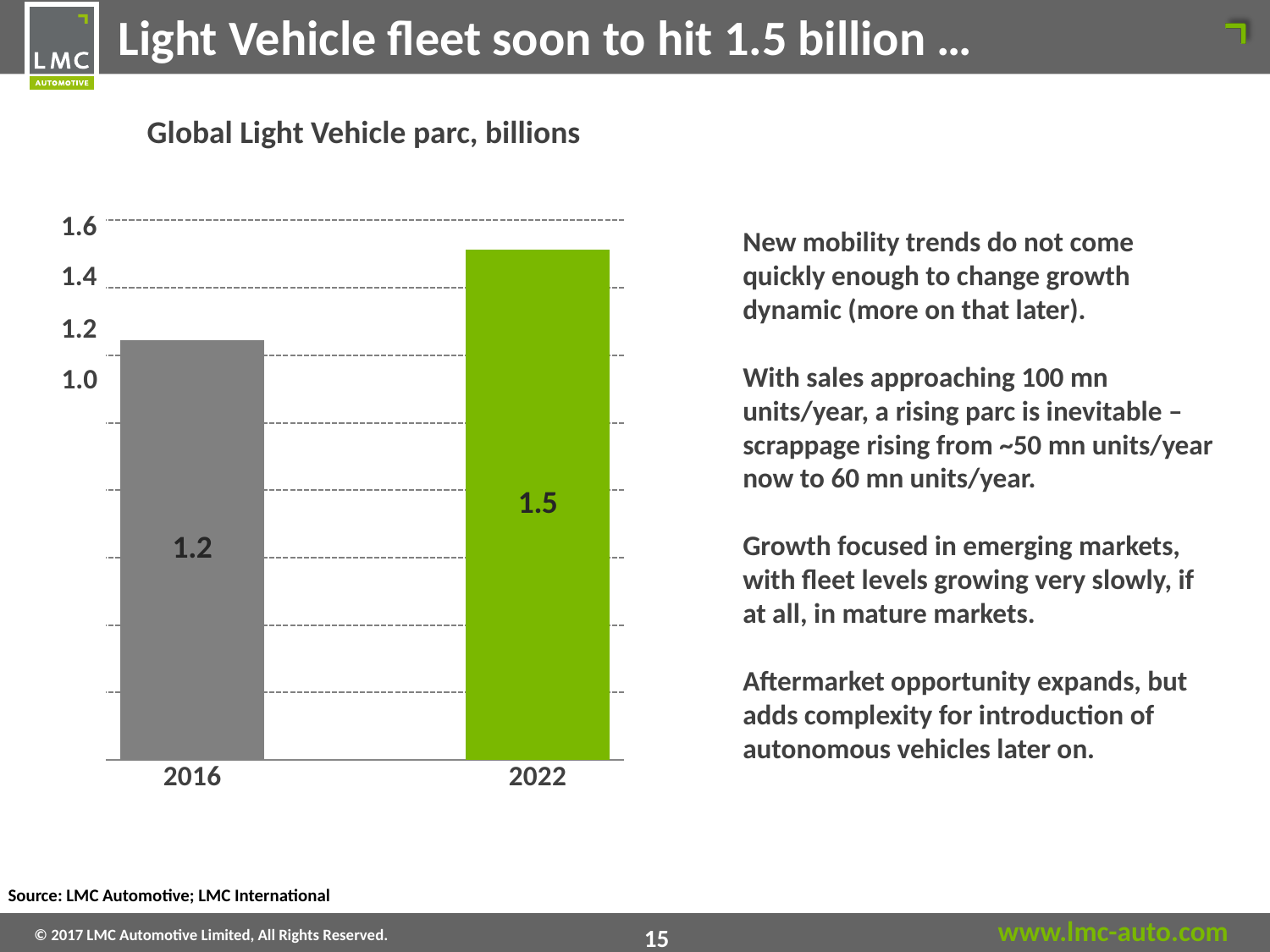
Is the value for 2022 larger or smaller than the value for 2016? larger How many years are shown on the chart? 2 By how much does the light vehicle parc value for 2022 exceed that for 2016? 0.3 Do the values rise or fall from 2016 to 2022? rise Which year has the higher light vehicle parc value? 2022 Which year has the lower light vehicle parc value? 2016 What is the title of the chart? Global Light Vehicle parc, billions Is the value for 2016 greater or less than 1.4? less What is the global light vehicle parc value shown for 2016? 1.2 What is the global light vehicle parc value shown for 2022? 1.5 Is the value for 2022 greater or less than 1.4? greater What kind of chart is shown on the slide? bar chart